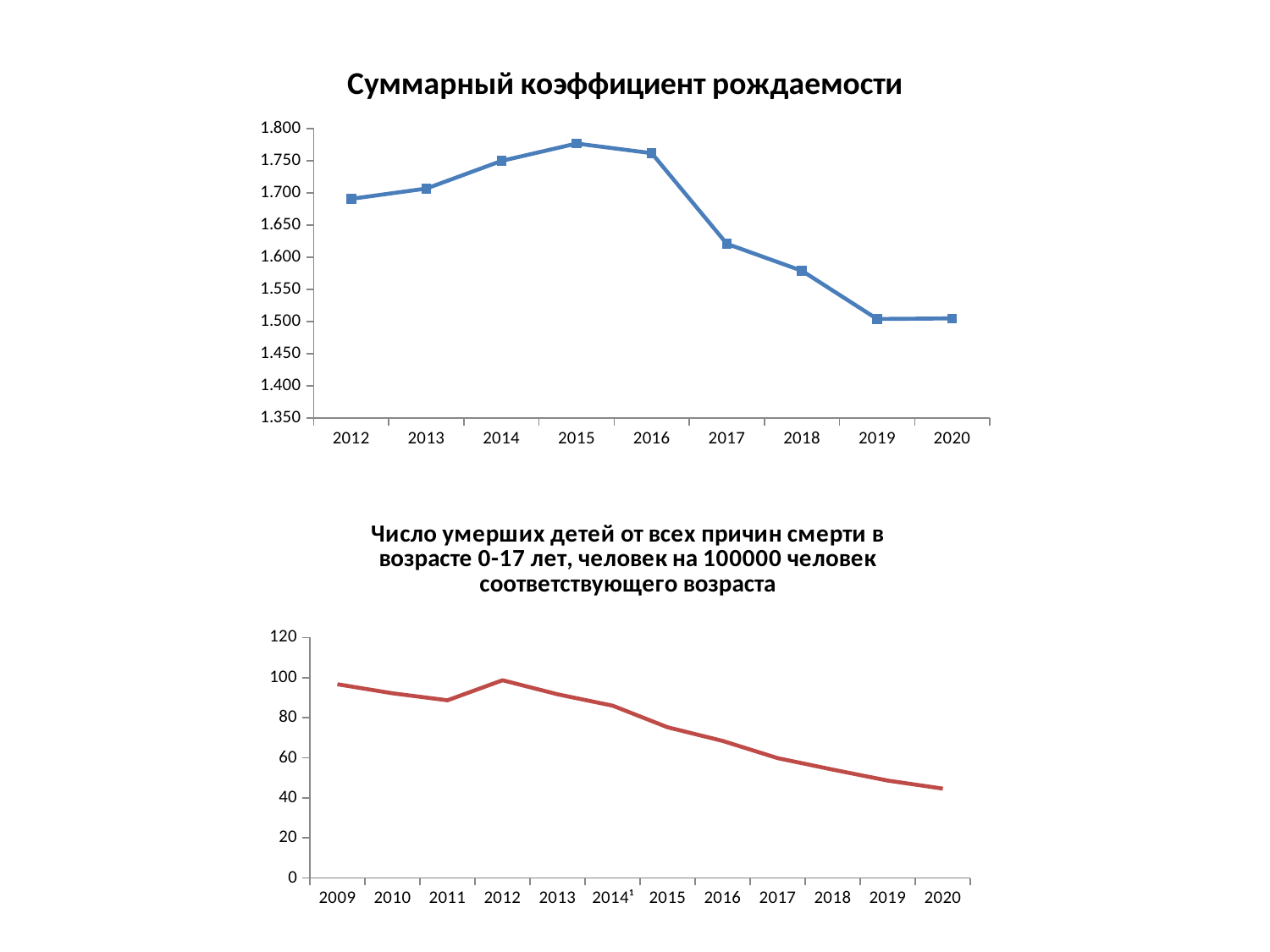
What type of chart is the top chart titled "Суммарный коэффициент рождаемости"? line chart In the bottom chart about the number of deceased children aged 0-17, is the value for 2017 greater or less than 80? less In the bottom chart about the number of deceased children aged 0-17, do the values rise or fall from 2012 to 2020? fall In the top chart "Суммарный коэффициент рождаемости", is the value for 2017 greater or less than 1.650? less In the top chart "Суммарный коэффициент рождаемости", which year has the highest value? 2015 In the top chart "Суммарный коэффициент рождаемости", do the values rise or fall from 2016 to 2019? fall In the top chart "Суммарный коэффициент рождаемости", how many years are shown on the x axis? 9 In the top chart "Суммарный коэффициент рождаемости", is the value for 2014 greater or less than 1.700? greater What type of chart is the bottom chart about the number of deceased children aged 0-17? line chart In the bottom chart about the number of deceased children aged 0-17, how many years are shown on the x axis? 12 In the bottom chart about the number of deceased children aged 0-17, which year has the lowest value? 2020 In the top chart "Суммарный коэффициент рождаемости", which is larger, the value for 2016 or the value for 2018? 2016